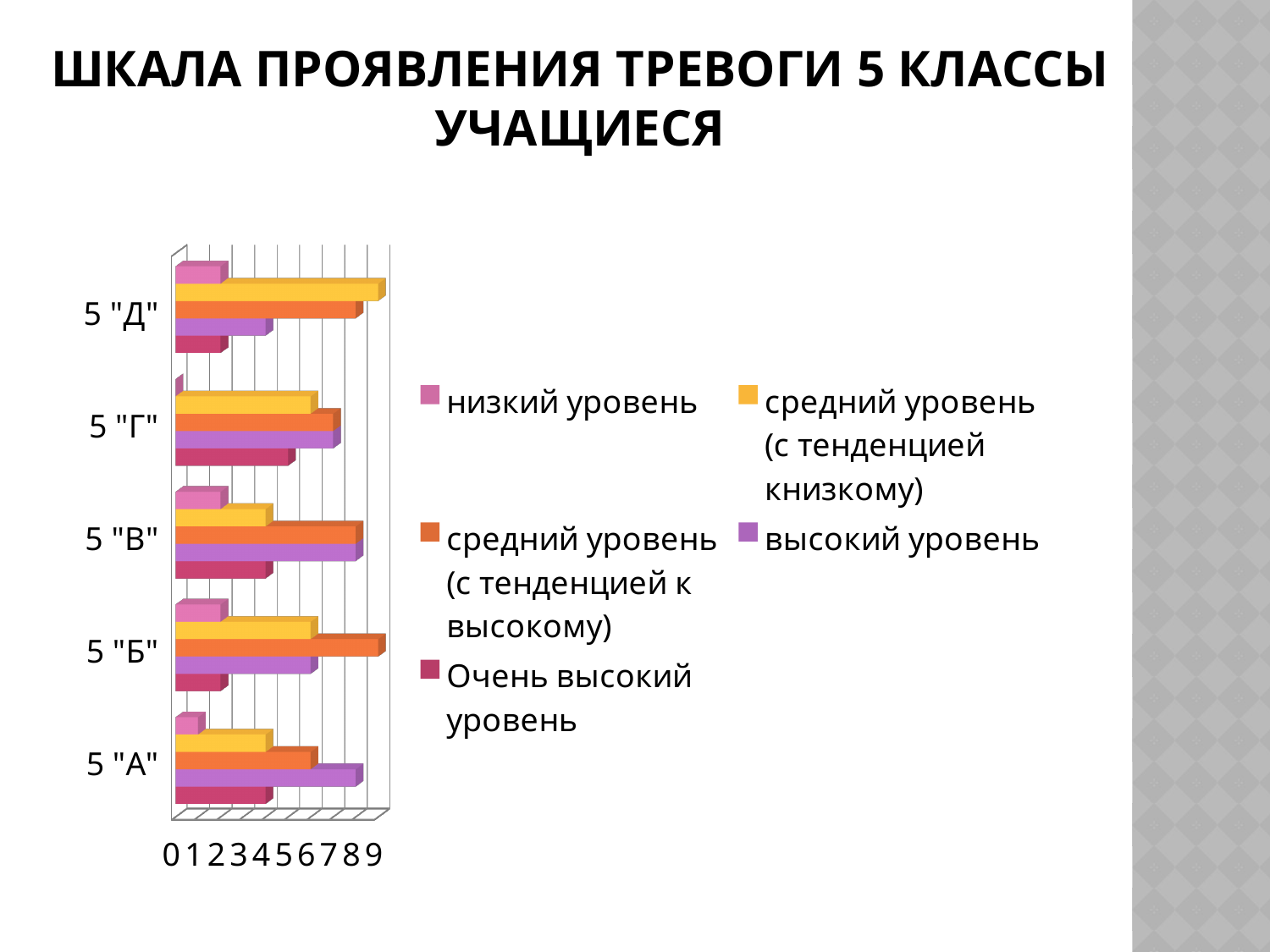
In class 5 "А", which series has the highest value? высокий уровень What kind of chart is shown on the slide? bar chart How many series does the legend list? 5 Is the value for "высокий уровень" in class 5 "А" greater or less than 5? greater In class 5 "Д", which is larger: "средний уровень (с тенденцией к низкому)" or "высокий уровень"? средний уровень (с тенденцией к низкому) In class 5 "Г", which series has the lowest value? низкий уровень What is the title of the slide? ШКАЛА ПРОЯВЛЕНИЯ ТРЕВОГИ 5 КЛАССЫ УЧАЩИЕСЯ Which colour represents "высокий уровень" in the legend? purple How many classes (categories) are shown on the chart? 5 Is the value for "низкий уровень" in class 5 "В" greater or less than 5? less Is the value for "средний уровень (с тенденцией к низкому)" in class 5 "Д" greater or less than 5? greater